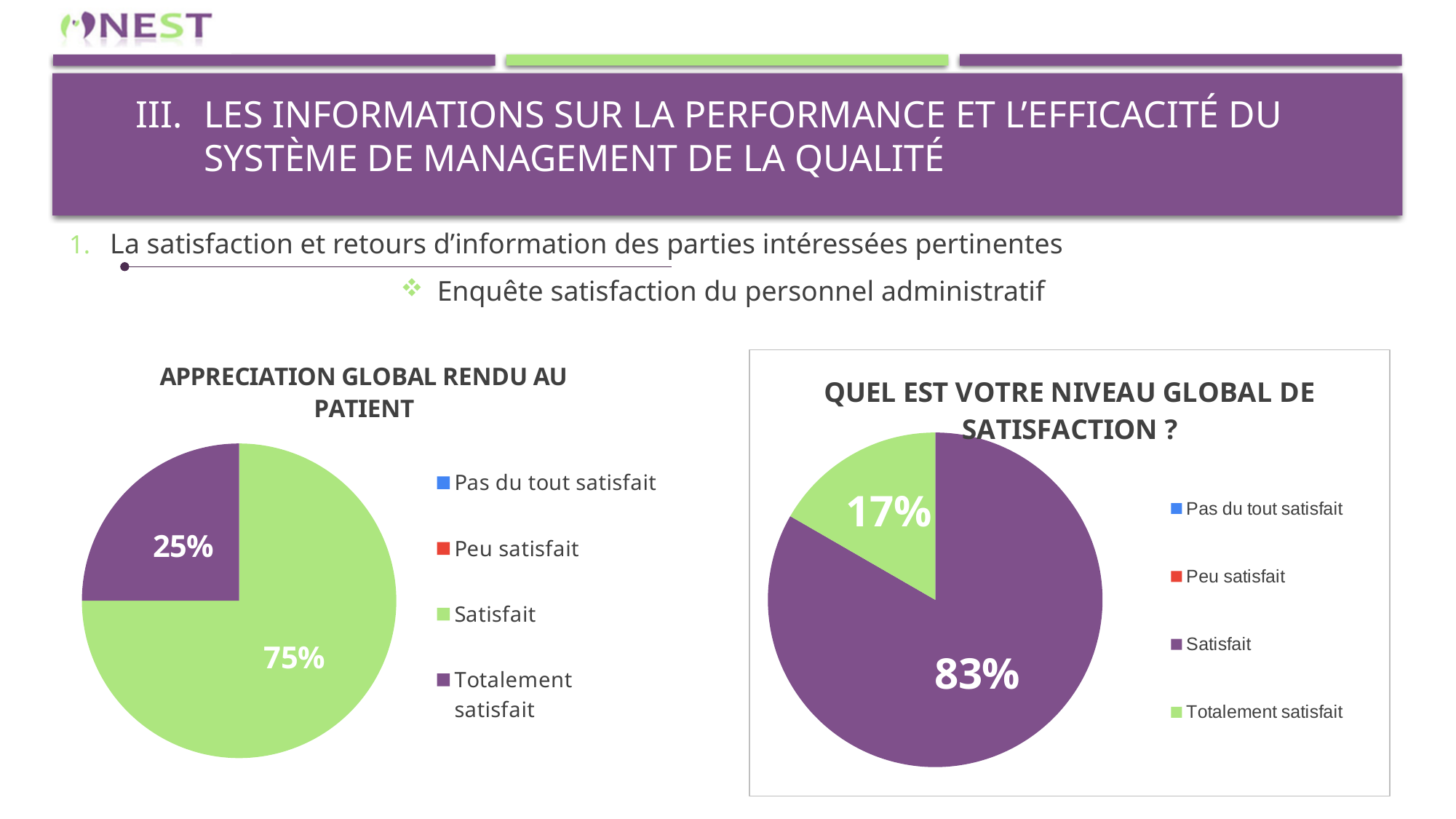
In the chart titled "QUEL EST VOTRE NIVEAU GLOBAL DE SATISFACTION ?", what share of the pie is labelled "Satisfait"? 83% In the chart titled "APPRECIATION GLOBAL RENDU AU PATIENT", what is the difference between the "Satisfait" and "Totalement satisfait" shares? 50% What type of chart is the chart titled "QUEL EST VOTRE NIVEAU GLOBAL DE SATISFACTION ?"? Pie chart How many entries does the legend of the chart titled "APPRECIATION GLOBAL RENDU AU PATIENT" list? 4 In the chart titled "QUEL EST VOTRE NIVEAU GLOBAL DE SATISFACTION ?", which category has the smallest visible slice? Totalement satisfait In the chart titled "APPRECIATION GLOBAL RENDU AU PATIENT", what share of the pie is labelled "Satisfait"? 75% In the chart titled "QUEL EST VOTRE NIVEAU GLOBAL DE SATISFACTION ?", what colour is the "Satisfait" slice? Purple In the chart titled "APPRECIATION GLOBAL RENDU AU PATIENT", which category has the largest slice? Satisfait In the chart titled "APPRECIATION GLOBAL RENDU AU PATIENT", what share of the pie is labelled "Totalement satisfait"? 25% In the chart titled "QUEL EST VOTRE NIVEAU GLOBAL DE SATISFACTION ?", what share of the pie is labelled "Totalement satisfait"? 17% Is the "Satisfait" share larger in the left chart ("APPRECIATION GLOBAL RENDU AU PATIENT") or in the right chart ("QUEL EST VOTRE NIVEAU GLOBAL DE SATISFACTION ?")? The right chart In the chart titled "QUEL EST VOTRE NIVEAU GLOBAL DE SATISFACTION ?", what is the difference between the "Satisfait" and "Totalement satisfait" shares? 66%